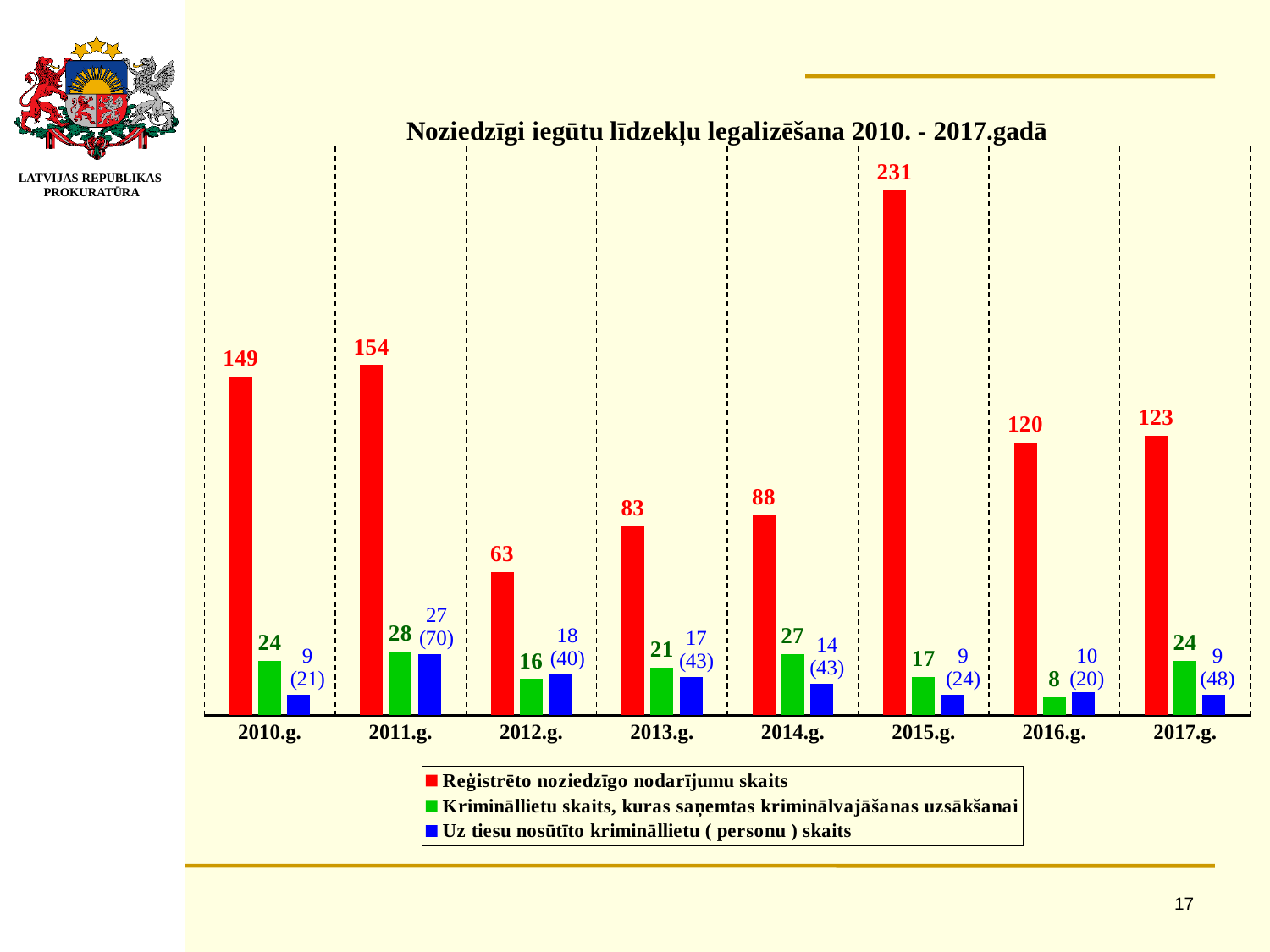
In which year is Reģistrēto noziedzīgo nodarījumu skaits the highest? 2015.g. What kind of chart is shown on the slide? bar chart How many series does the legend list? 3 Which year has the larger Reģistrēto noziedzīgo nodarījumu skaits, 2010.g. or 2011.g.? 2011.g. Does Reģistrēto noziedzīgo nodarījumu skaits rise or fall from 2012.g. to 2015.g.? rise What is the value of Reģistrēto noziedzīgo nodarījumu skaits for 2015.g.? 231 How many years are shown on the x axis of the chart? 8 In which year is Reģistrēto noziedzīgo nodarījumu skaits the lowest? 2012.g. What is the difference between Reģistrēto noziedzīgo nodarījumu skaits in 2015.g. and 2016.g.? 111 In which year is Krimināllietu skaits, kuras saņemtas kriminālvajāšanas uzsākšanai the lowest? 2016.g. What is the value of Krimināllietu skaits, kuras saņemtas kriminālvajāšanas uzsākšanai for 2011.g.? 28 What is the data label shown for Uz tiesu nosūtīto krimināllietu (personu) skaits in 2017.g.? 9 (48)